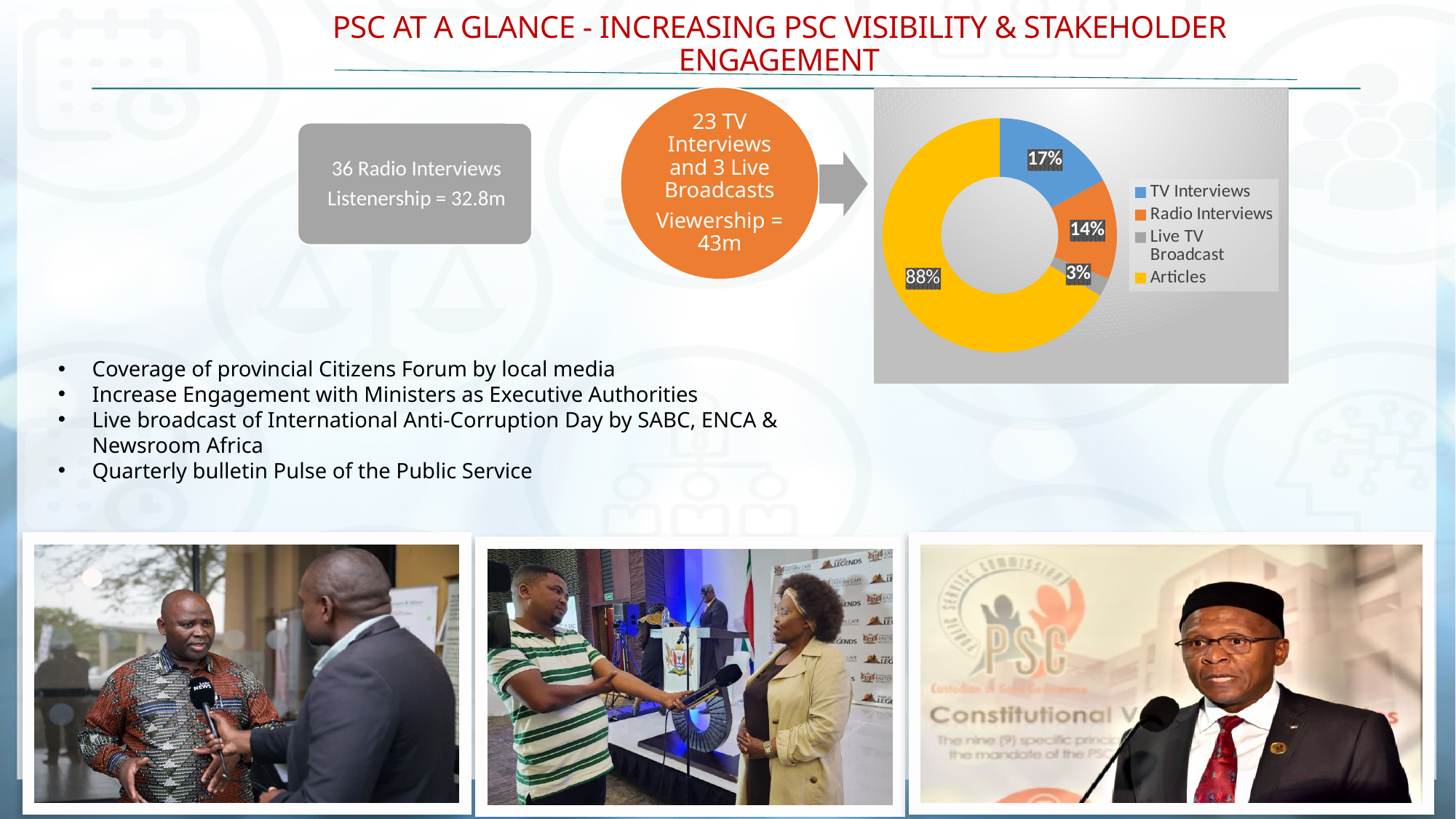
What kind of chart is shown on the slide? doughnut chart What percentage is shown for Radio Interviews in the doughnut chart? 14% How many categories does the doughnut chart show? 4 Which category has the largest share in the doughnut chart? Articles Which has a larger share in the doughnut chart, TV Interviews or Live TV Broadcast? TV Interviews Which category is shown in orange in the doughnut chart legend? Radio Interviews What colour is the Articles segment in the doughnut chart? yellow What percentage is shown for Articles in the doughnut chart? 88% Which category has the smallest share in the doughnut chart? Live TV Broadcast What percentage is shown for Live TV Broadcast in the doughnut chart? 3% What percentage is shown for TV Interviews in the doughnut chart? 17% What is the difference between the percentages shown for TV Interviews and Radio Interviews? 3%